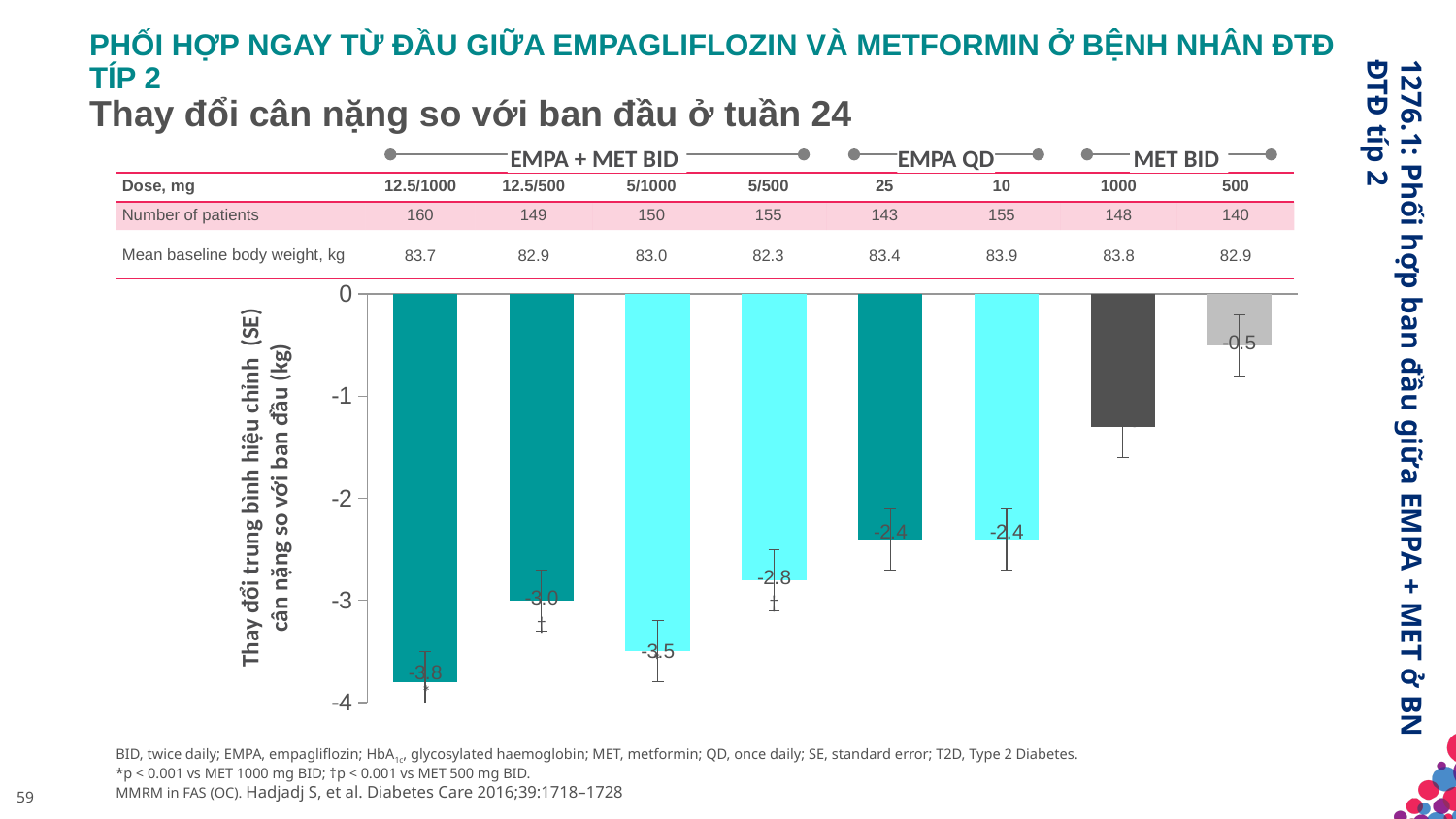
What type of chart is used to show the change in body weight? bar chart Is the value for the MET BID 1000 mg group greater or less than -1? less What is the mean change in body weight from baseline for the MET BID 500 mg group? -0.5 What is the mean change in body weight from baseline for the EMPA + MET BID 5/1000 mg group? -3.5 What is the mean change in body weight from baseline for the EMPA + MET BID 12.5/1000 mg group? -3.8 Which dose group shows the largest reduction in body weight from baseline? EMPA + MET BID 12.5/1000 mg Which dose group shows the smallest reduction in body weight from baseline? MET BID 500 mg Which group shows a larger reduction in body weight: EMPA + MET BID 12.5/500 mg or EMPA + MET BID 5/1000 mg? EMPA + MET BID 5/1000 mg What is the title of the chart? Thay đổi cân nặng so với ban đầu ở tuần 24 What is the mean change in body weight from baseline for the EMPA QD 25 mg group? -2.4 What is the difference in mean body weight change between the EMPA + MET BID 12.5/1000 mg group and the 12.5/500 mg group? 0.8 kg How many dose groups (bars) are shown in the chart? 8